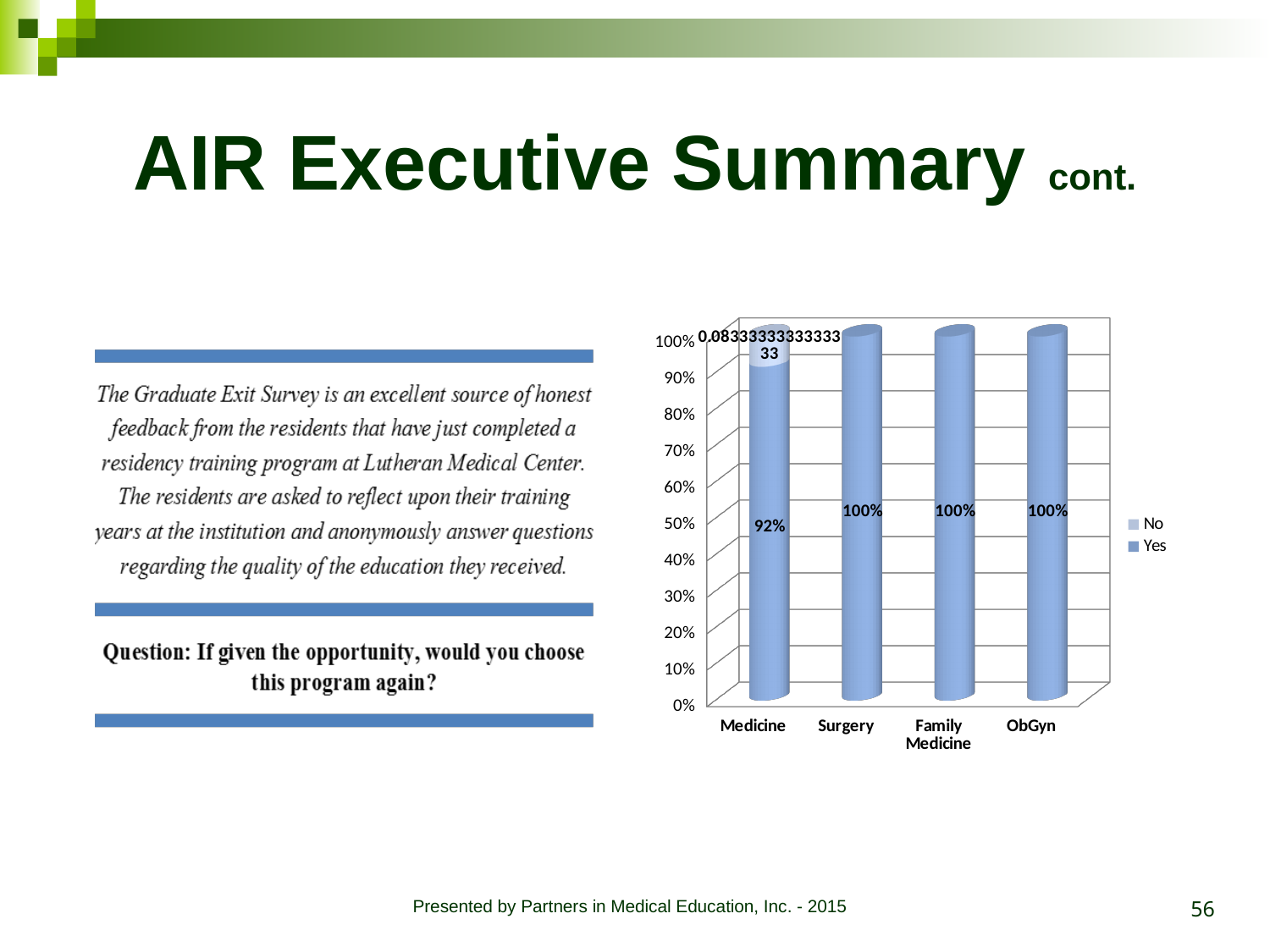
Which program is the only one with a visible "No" segment? Medicine How many programs are shown on the x axis? 4 What kind of chart is shown on the slide? Bar chart What is the "Yes" value for Surgery? 100% What is the difference between the "Yes" values for Surgery and Medicine? 8% What is the "Yes" value for Medicine? 92% Is the "Yes" value for Medicine greater or less than 90%? greater Which is larger, the "Yes" value for Medicine or for ObGyn? ObGyn How many series does the legend list? 2 What is the "Yes" value for ObGyn? 100% What is the "Yes" value for Family Medicine? 100% Which program has the lowest "Yes" value? Medicine